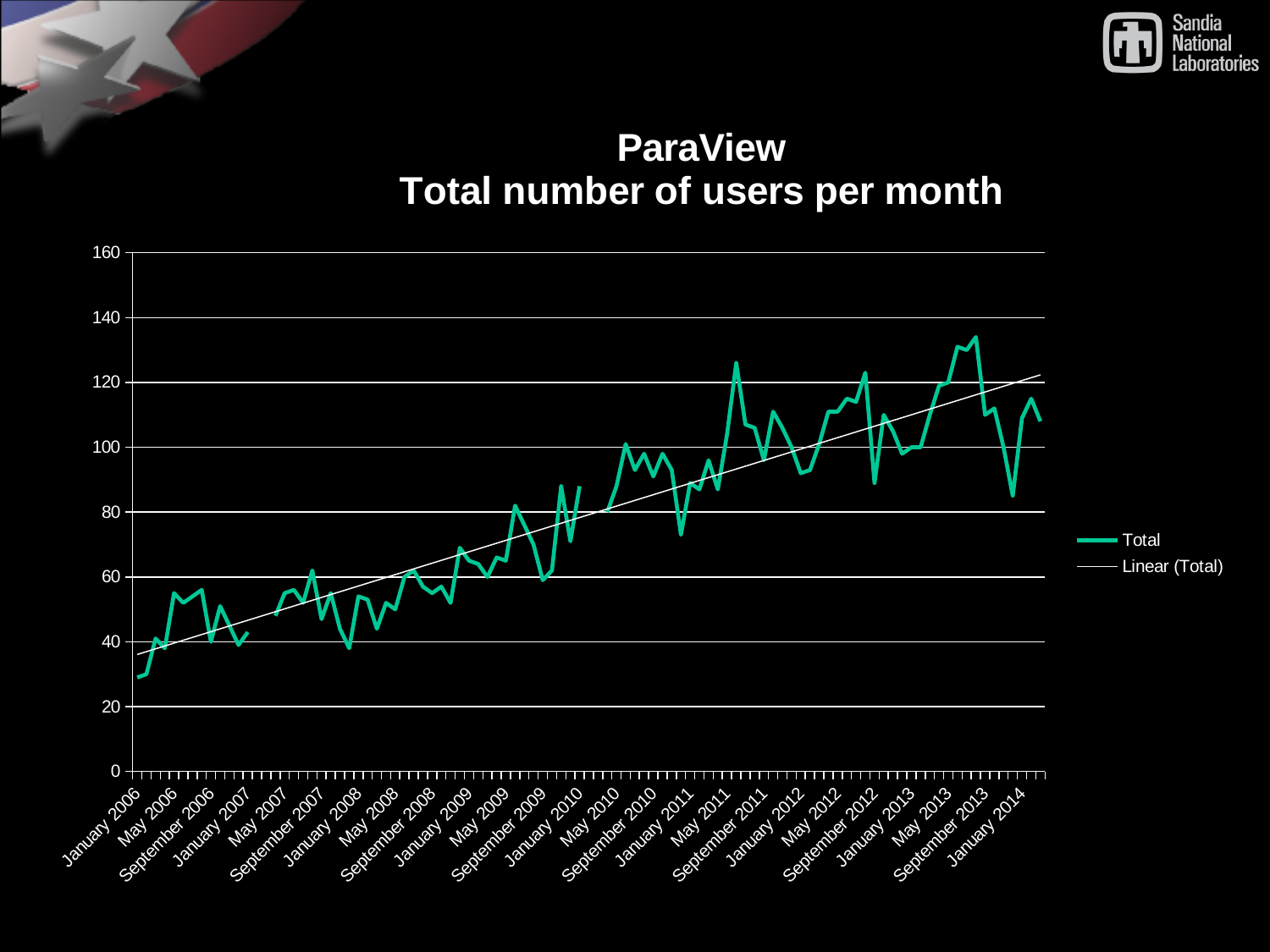
What kind of chart is shown on the slide? line chart What is the title of the chart? ParaView Total number of users per month Is the value for January 2014 greater or less than 80? greater What are the two entries in the chart legend? Total and Linear (Total) How many series does the legend list? 2 Is the value for May 2012 greater or less than 80? greater Which labeled month has the lowest value on the Total line? January 2006 Which is larger, the value for January 2006 or the value for January 2014? January 2014 Is the value for January 2009 greater or less than 80? less Do the values generally rise or fall from January 2006 to January 2014? rise